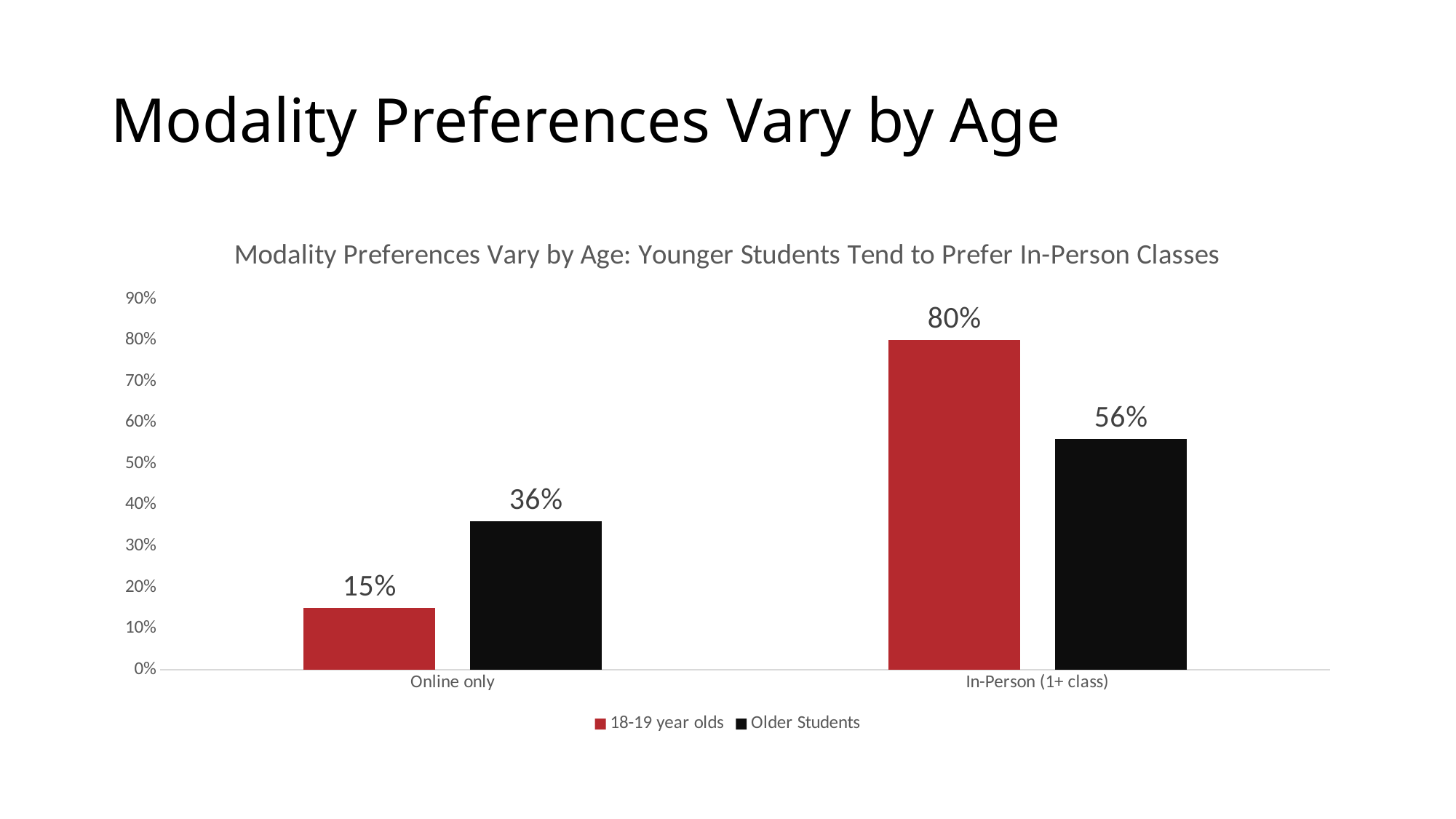
What is the difference between the 18-19 year olds and Older Students values for In-Person (1+ class)? 24% How many categories are shown on the x axis? 2 Which bar has the highest value on the chart? 18-19 year olds, In-Person (1+ class) Which bar has the lowest value on the chart? 18-19 year olds, Online only What percentage of Older Students prefer Online only? 36% How many series does the legend list? 2 What percentage of Older Students prefer In-Person (1+ class)? 56% For Online only, which group has the larger value: 18-19 year olds or Older Students? Older Students What type of chart is shown on the slide? Bar chart What is the difference between the Older Students and 18-19 year olds values for Online only? 21% What percentage of 18-19 year olds prefer Online only? 15% What percentage of 18-19 year olds prefer In-Person (1+ class)? 80%